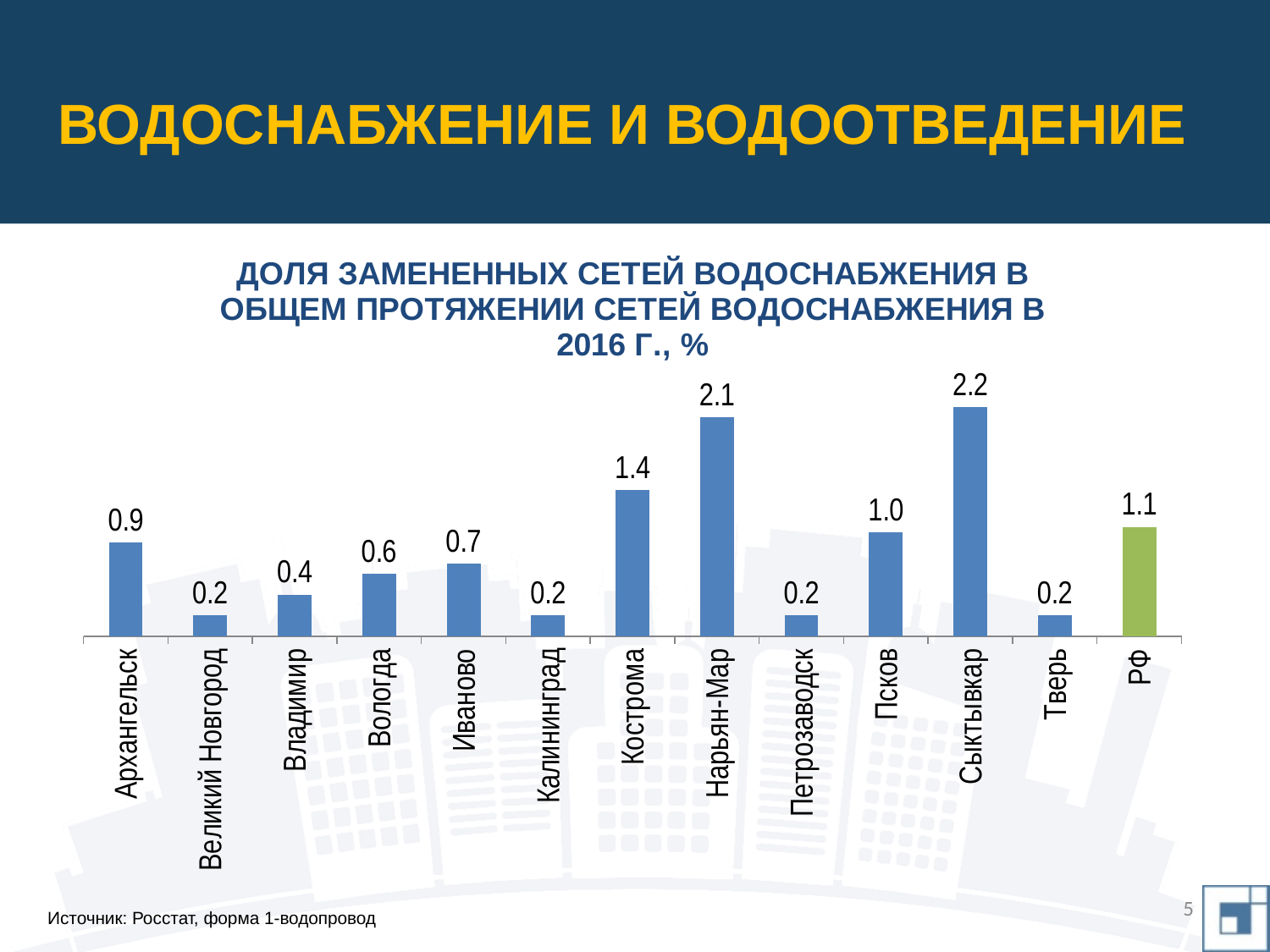
How many categories are shown on the x axis? 13 Which bar is shown in a different colour (green) from the others? РФ Which is larger, the value for Архангельск or the value for Вологда? Архангельск What year does the chart title refer to? 2016 What is the difference between the values for Нарьян-Мар and Псков? 1.1 How many categories have a value of 0.2? 4 What is the difference between the values for Сыктывкар and РФ? 1.1 What is the value for Кострома? 1.4 Which category has the highest value? Сыктывкар What is the value for РФ? 1.1 What kind of chart is shown on the slide? bar chart What is the value for Сыктывкар? 2.2